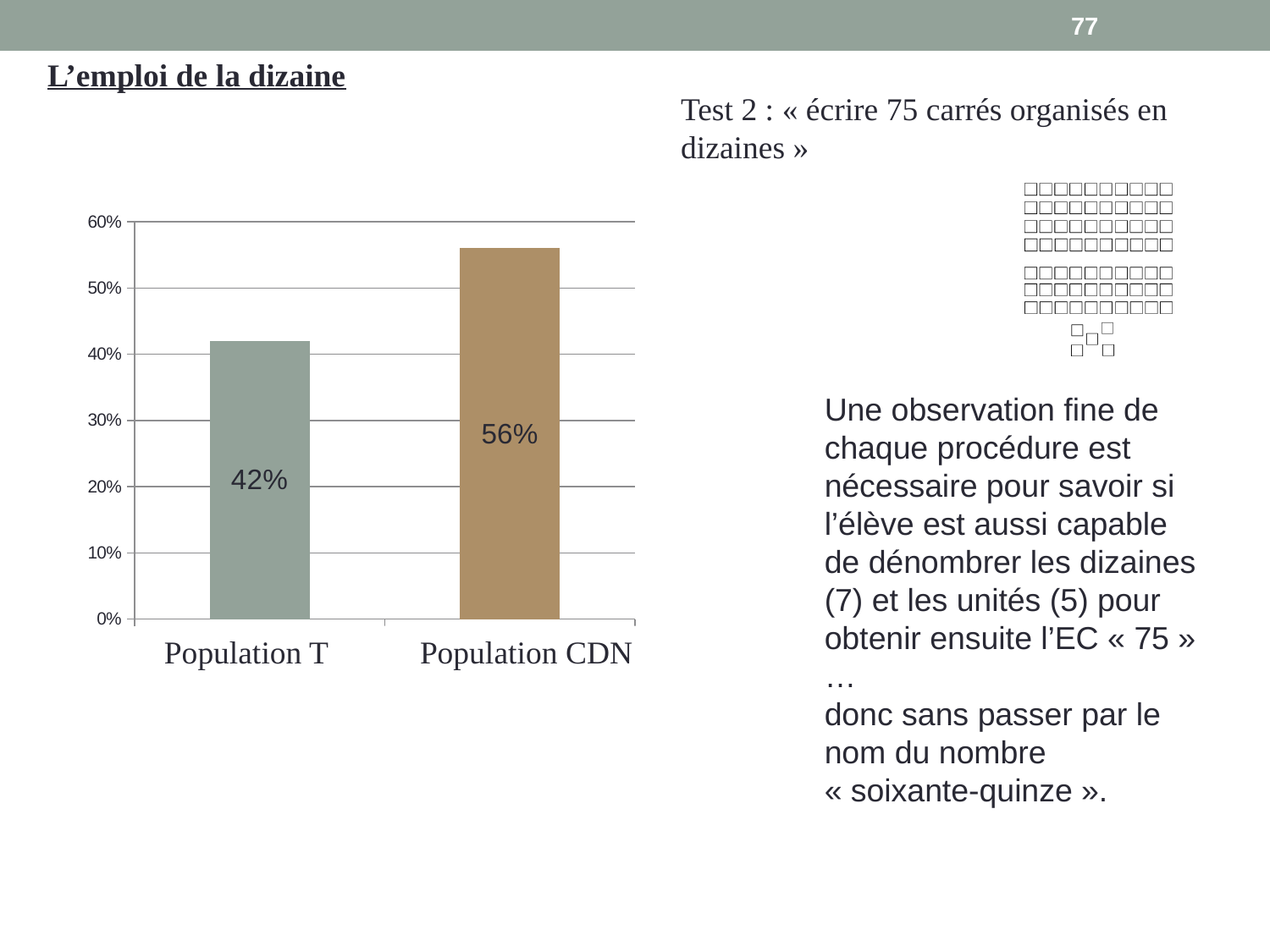
Is the value for Population T greater or less than 50%? less What kind of chart is shown on the slide? bar chart Is the value for Population CDN greater or less than 50%? greater How many categories are shown in the chart? 2 What is the difference between the values for Population CDN and Population T? 14% What is the maximum value shown on the vertical axis? 60% What is the value for Population CDN? 56% What is the value for Population T? 42% Which category has the lowest value? Population T What is the title of the slide above the chart? L'emploi de la dizaine Which is larger, the value for Population T or the value for Population CDN? Population CDN Which category has the highest value? Population CDN